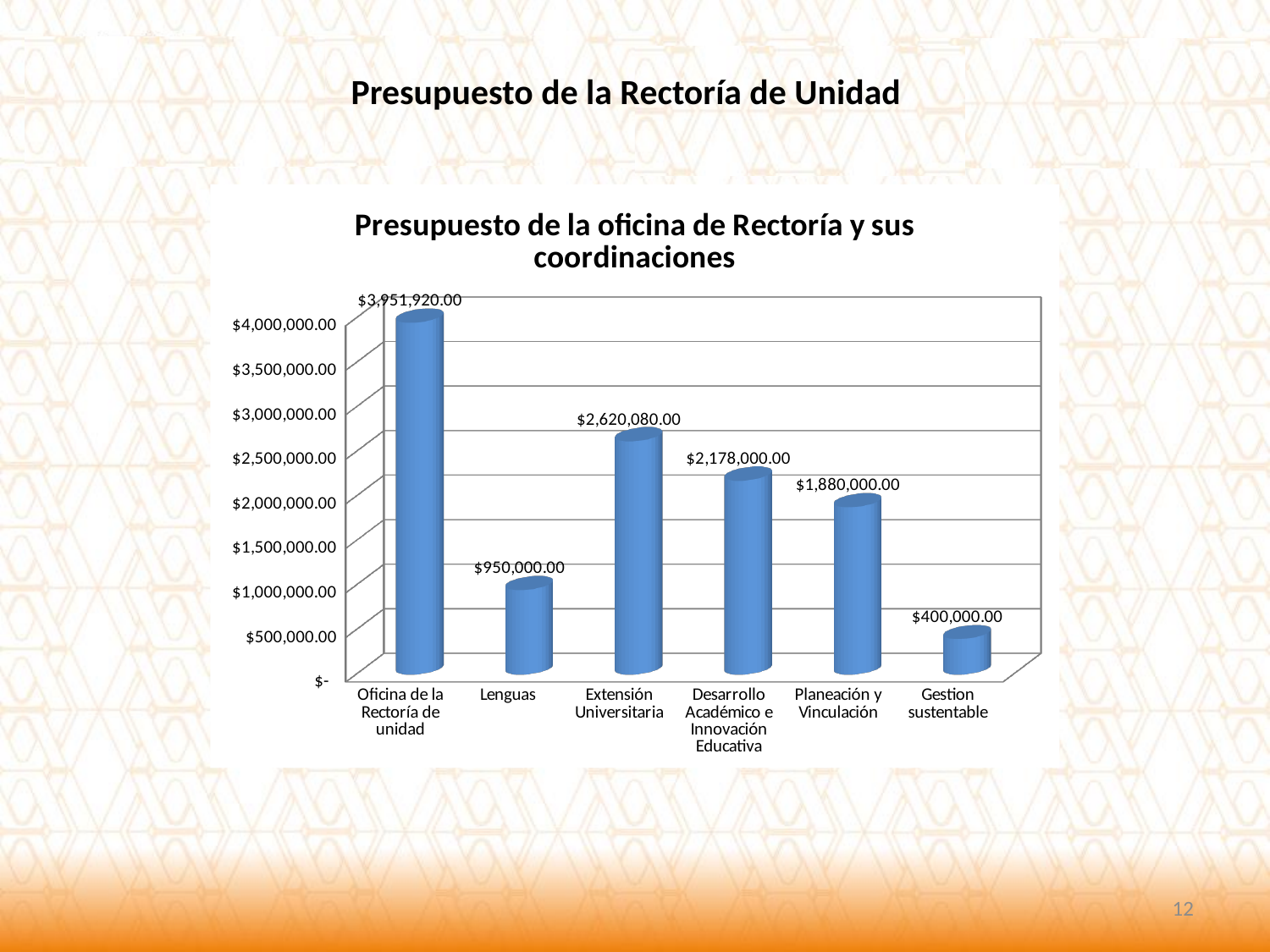
How many categories are shown in the chart? 6 Which category has the lowest value? Gestion sustentable Is the value for Lenguas greater or less than $1,000,000.00? less Which is larger, the value for Desarrollo Académico e Innovación Educativa or the value for Planeación y Vinculación? Desarrollo Académico e Innovación Educativa Which category has the highest value? Oficina de la Rectoría de unidad What is the value for Gestion sustentable? $400,000.00 What is the difference between the values for Lenguas and Gestion sustentable? $550,000.00 What is the value for Extensión Universitaria? $2,620,080.00 What is the value for Oficina de la Rectoría de unidad? $3,951,920.00 What is the value for Planeación y Vinculación? $1,880,000.00 What type of chart is shown on the slide? bar chart What is the difference between the values for Oficina de la Rectoría de unidad and Extensión Universitaria? $1,331,840.00